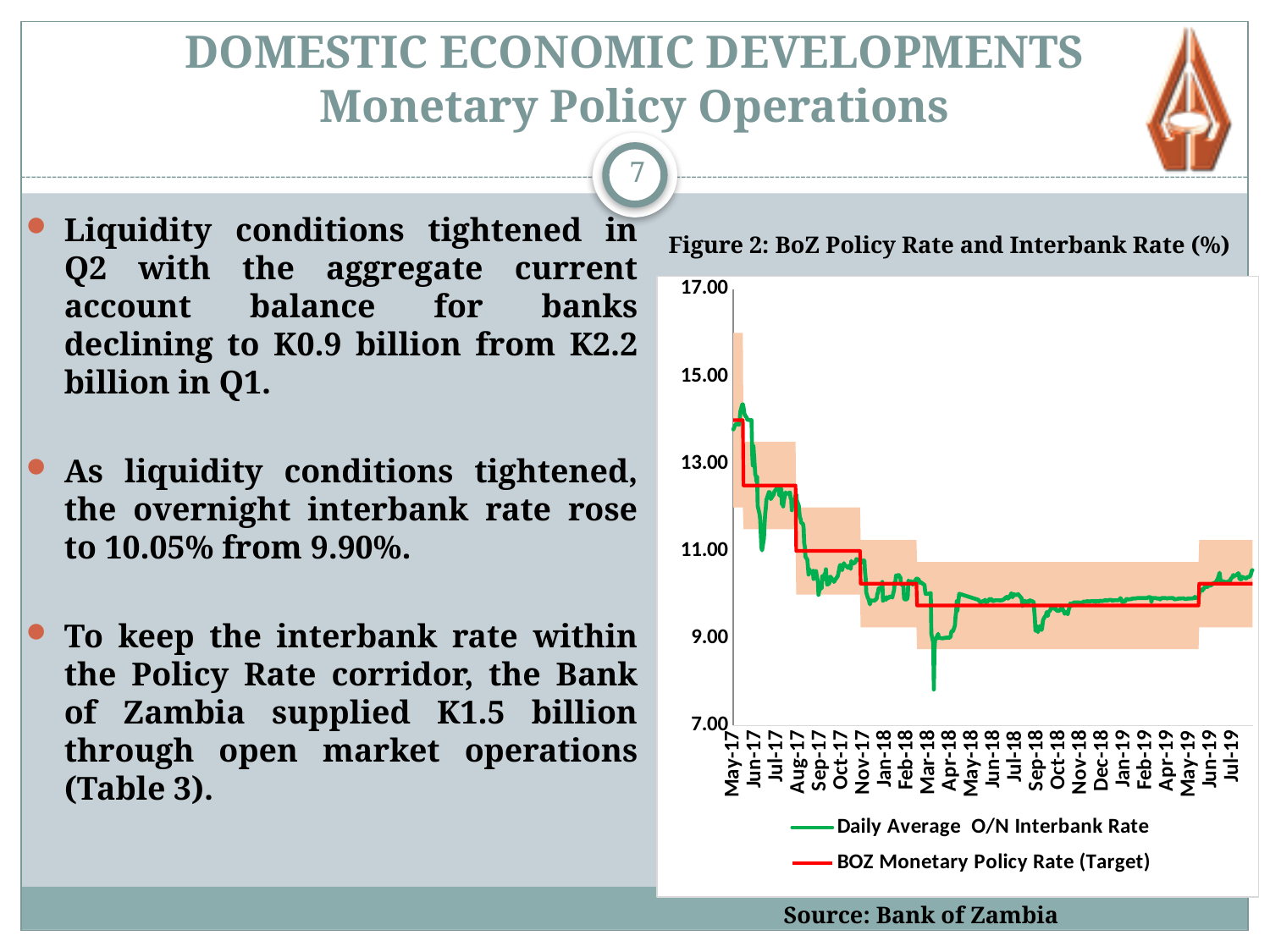
What is the title of the chart on the slide? Figure 2: BoZ Policy Rate and Interbank Rate (%) In Figure 2, which series is drawn in red? BOZ Monetary Policy Rate (Target) In Figure 2, is the Daily Average O/N Interbank Rate in May-17 greater or less than 13.00? greater In Figure 2, is the lowest point of the Daily Average O/N Interbank Rate around Mar-18 greater or less than 9.00? less In Figure 2, at the sharp dip around Mar-18, which is higher: the Daily Average O/N Interbank Rate or the BOZ Monetary Policy Rate (Target)? BOZ Monetary Policy Rate (Target) In Figure 2, is the BOZ Monetary Policy Rate (Target) in Jan-19 greater or less than 11.00? less What kind of chart is Figure 2: BoZ Policy Rate and Interbank Rate (%)? Line chart In Figure 2, what is the highest value shown on the vertical axis? 17.00 How many series does the legend of Figure 2 list? 2 In Figure 2, does the BOZ Monetary Policy Rate (Target) rise or fall from May-17 to Jan-19? fall In Figure 2, does the Daily Average O/N Interbank Rate rise or fall overall from May-17 to Jul-19? fall